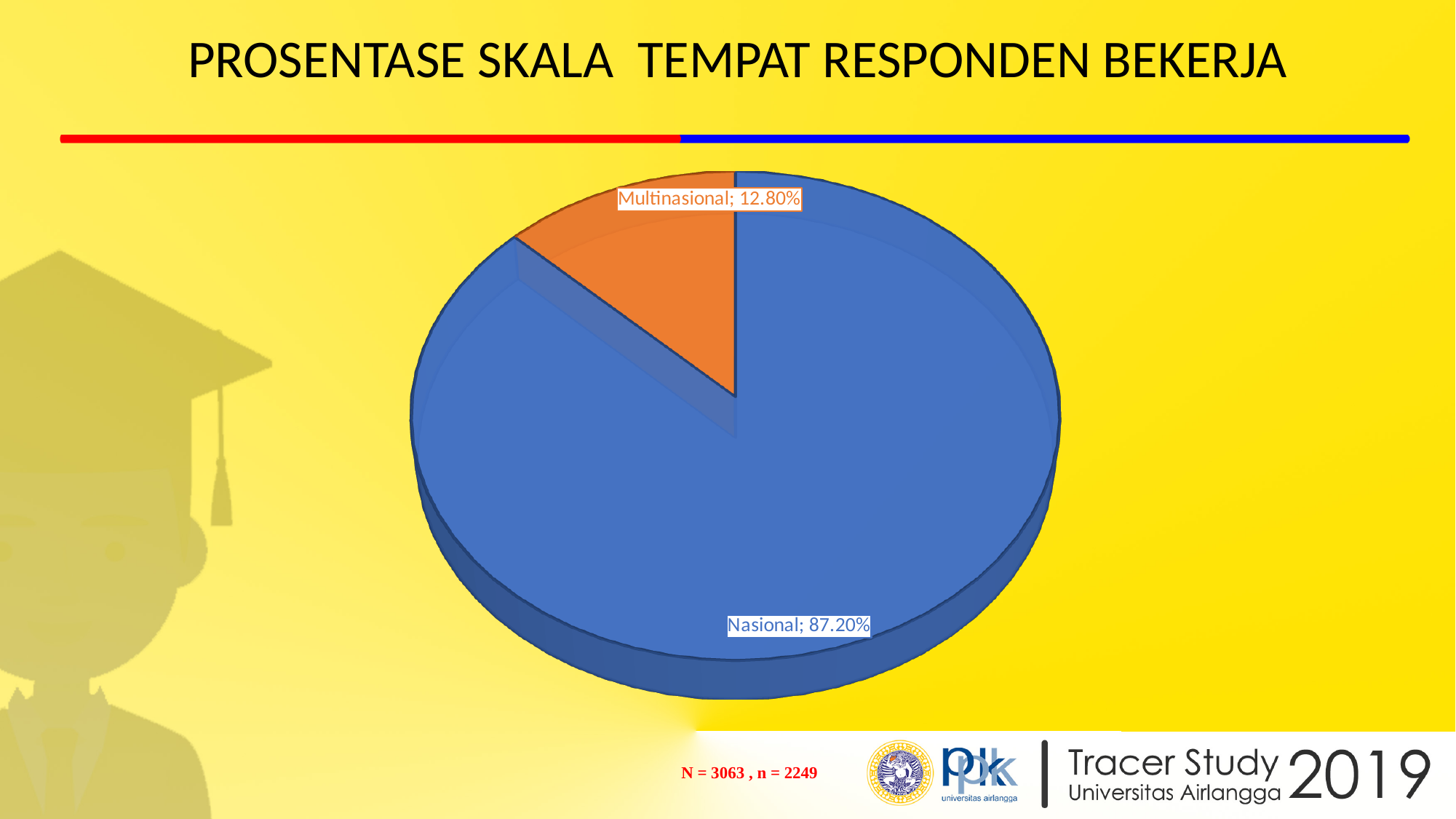
Which is larger, the Nasional share or the Multinasional share? Nasional What colour is the Multinasional slice? Orange What is the difference in percentage points between the Nasional and Multinasional shares? 74.40% What kind of chart is shown on the slide? Pie chart How many categories are shown in the pie chart? 2 What is the total of the two slices shown in the pie chart? 100.00% What percentage of respondents work at a Multinasional-scale workplace? 12.80% What percentage of respondents work at a Nasional-scale workplace? 87.20% Which category has the smallest share of the pie? Multinasional What is the title of the slide? PROSENTASE SKALA TEMPAT RESPONDEN BEKERJA Which category has the largest share of the pie? Nasional